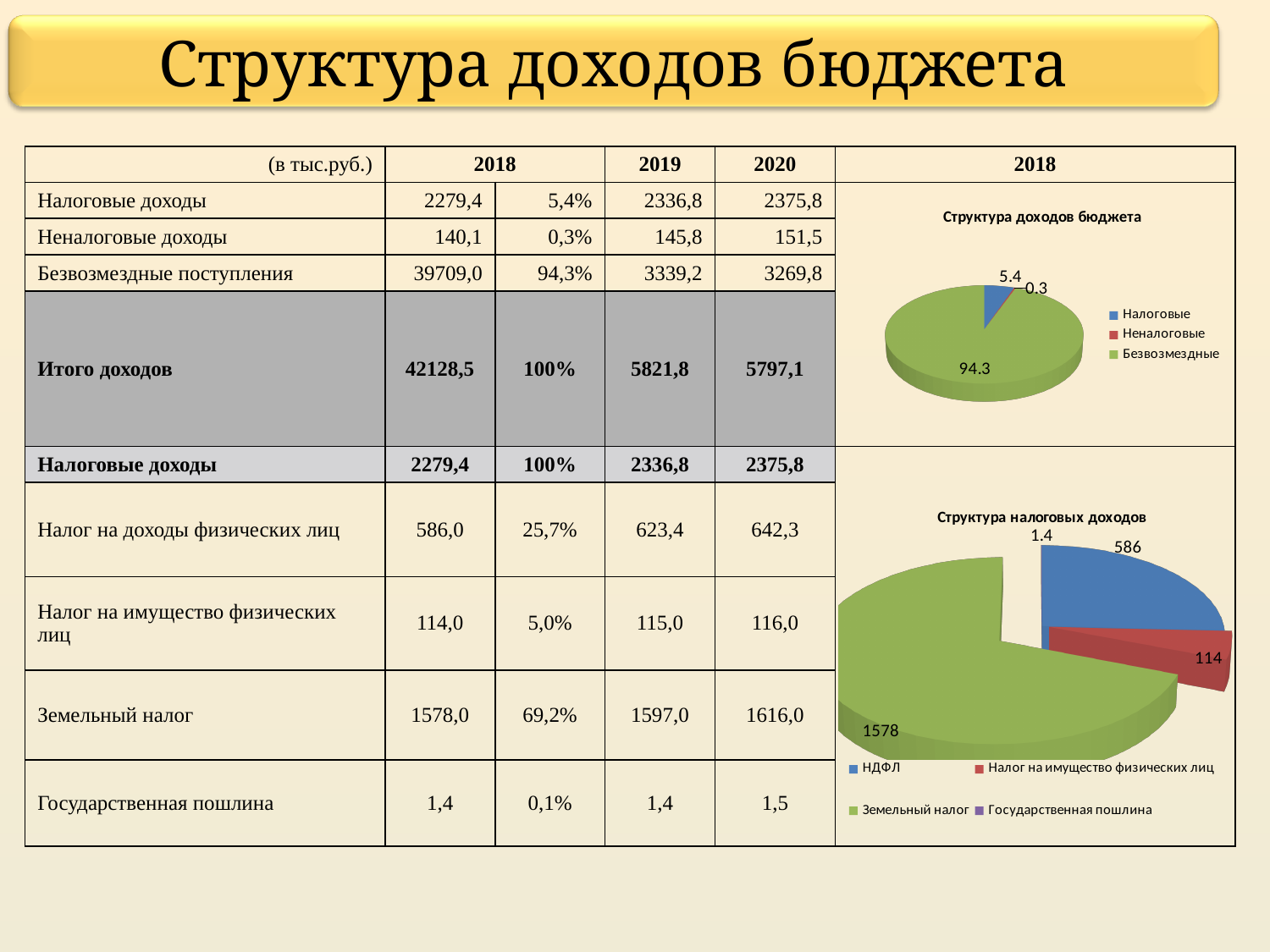
In the chart titled "Структура доходов бюджета", how many entries does the legend list? 3 In the chart titled "Структура налоговых доходов", what is the difference between the Земельный налог value and the НДФЛ value? 992 In the chart titled "Структура доходов бюджета", what value is shown for the Налоговые slice? 5.4 In the chart titled "Структура налоговых доходов", how many slices does the pie have? 4 In the chart titled "Структура налоговых доходов", what value is shown for Налог на имущество физических лиц? 114 In the chart titled "Структура налоговых доходов", what value is shown for Земельный налог? 1578 What kind of chart is the chart titled "Структура налоговых доходов"? Pie chart In the chart titled "Структура доходов бюджета", what value is shown for the Безвозмездные slice? 94.3 In the chart titled "Структура налоговых доходов", which is larger: НДФЛ or Налог на имущество физических лиц? НДФЛ In the chart titled "Структура доходов бюджета", which category has the smallest slice? Неналоговые In the chart titled "Структура налоговых доходов", which category has the largest slice? Земельный налог In the chart titled "Структура доходов бюджета", what is the difference between the Безвозмездные value and the Налоговые value? 88.9